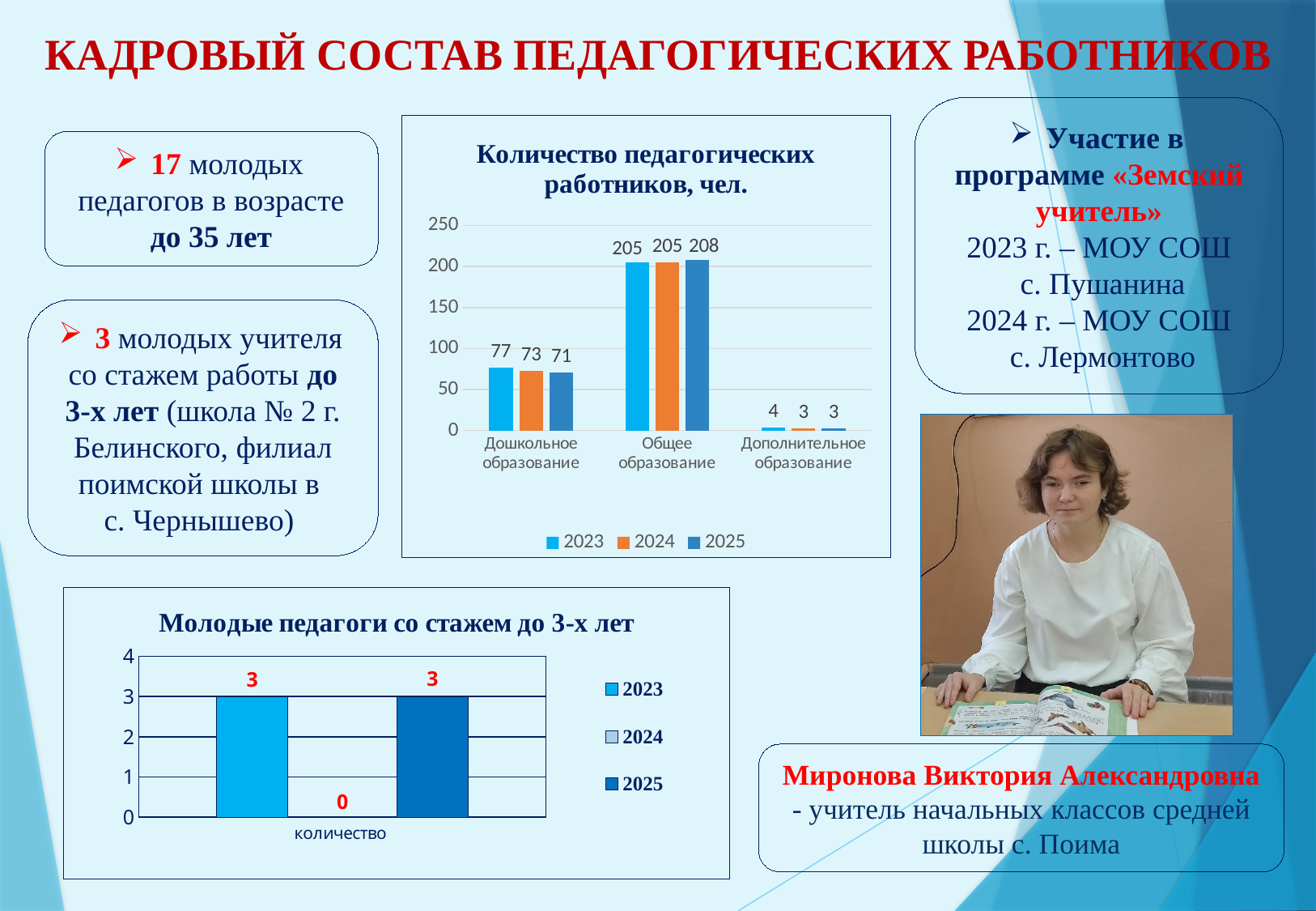
In the chart 'Количество педагогических работников, чел.', what is the value for Дошкольное образование in 2023? 77 In the chart 'Молодые педагоги со стажем до 3-х лет', what is the value for 2025? 3 In the chart 'Количество педагогических работников, чел.', what is the value for Дополнительное образование in 2024? 3 What kind of chart is 'Молодые педагоги со стажем до 3-х лет'? bar chart In the chart 'Количество педагогических работников, чел.', what is the difference between the 2023 and 2025 values for Дошкольное образование? 6 In the chart 'Количество педагогических работников, чел.', how many series does the legend list? 3 In the chart 'Количество педагогических работников, чел.', which category has the lowest values? Дополнительное образование In the chart 'Количество педагогических работников, чел.', which category has the highest values? Общее образование In the chart 'Количество педагогических работников, чел.', what is the value for Общее образование in 2025? 208 In the chart 'Молодые педагоги со стажем до 3-х лет', which series has the lowest value? 2024 In the chart 'Молодые педагоги со стажем до 3-х лет', what is the value for 2024? 0 In the chart 'Количество педагогических работников, чел.', do the values for Дошкольное образование rise or fall from 2023 to 2025? fall